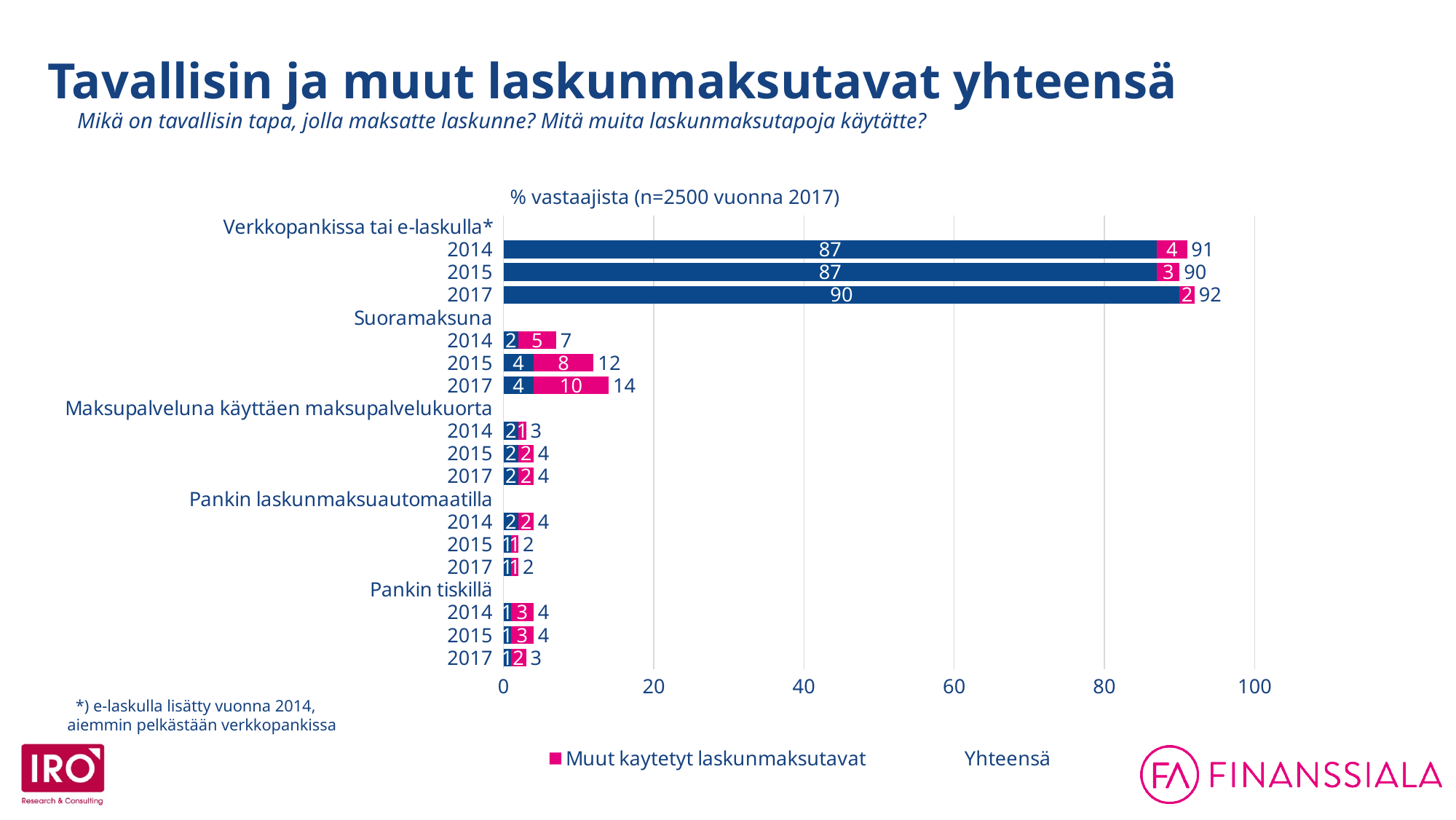
What is the total for Suoramaksuna in 2015? 12 What is the axis label shown above the chart? % vastaajista (n=2500 vuonna 2017) What is the value of the pink segment (Muut kaytetyt laskunmaksutavat) for Suoramaksuna in 2017? 10 Which year has the highest total for Verkkopankissa tai e-laskulla? 2017 Is the dark blue value for Verkkopankissa tai e-laskulla in 2015 greater or less than 80? greater What is the difference between the Suoramaksuna totals for 2017 and 2014? 7 What is the total for Pankin laskunmaksuautomaatilla in 2015? 2 What is the total (Yhteensä) for Verkkopankissa tai e-laskulla in 2014? 91 Is the total for Suoramaksuna in 2017 larger than the total for Pankin tiskillä in 2017? Yes What is the value of the dark blue segment for Verkkopankissa tai e-laskulla in 2017? 90 What kind of chart is shown on the slide? bar chart Which year has the lowest total for Suoramaksuna? 2014